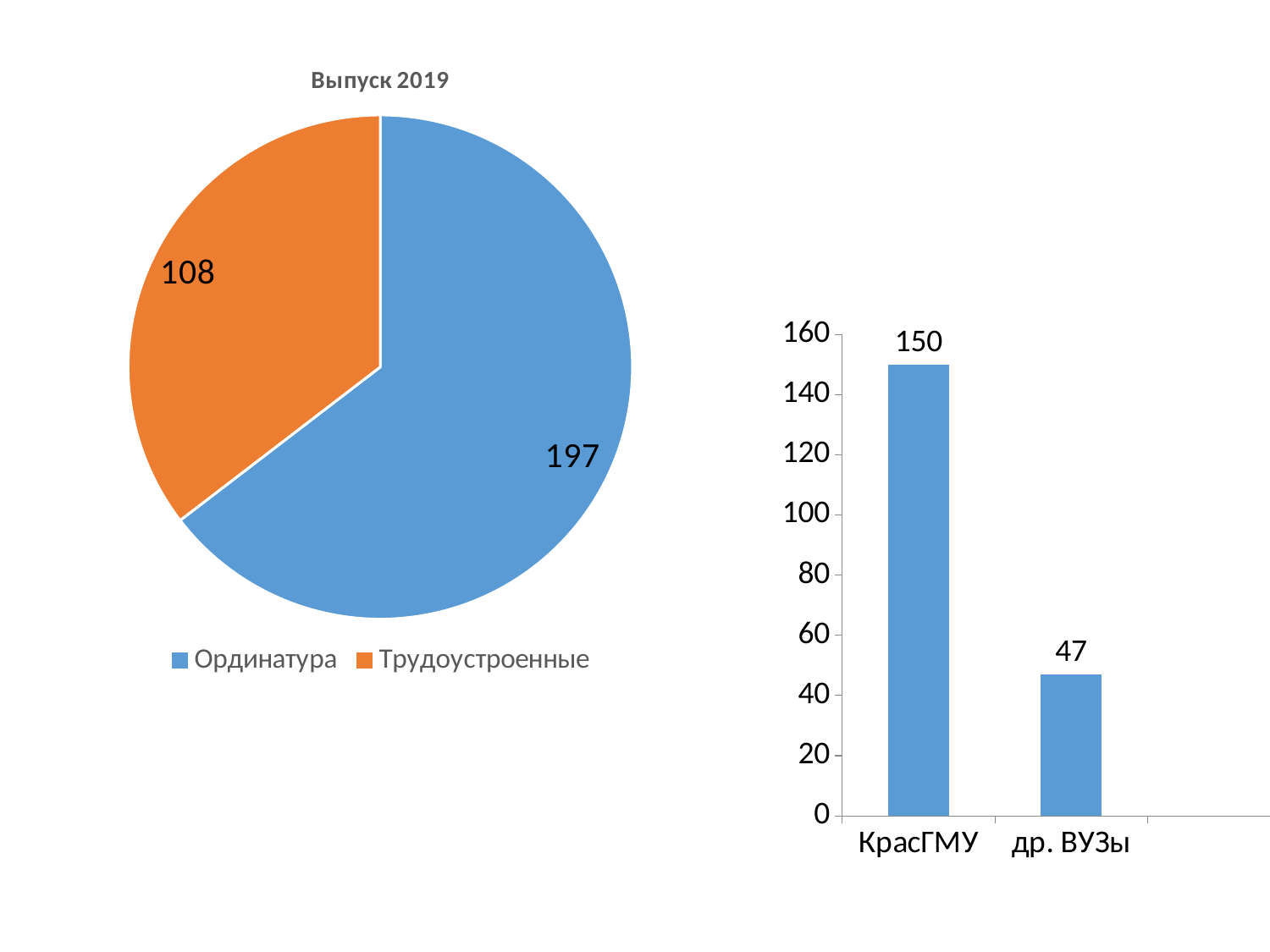
In the pie chart titled 'Выпуск 2019', which category has the larger value? Ординатура In the pie chart titled 'Выпуск 2019', what is the difference between Ординатура and Трудоустроенные? 89 In the bar chart on the right, what is the value for др. ВУЗы? 47 In the bar chart on the right, which category has the lowest value? др. ВУЗы In the pie chart titled 'Выпуск 2019', what colour is the Трудоустроенные slice? Orange In the bar chart on the right, what is the difference between КрасГМУ and др. ВУЗы? 103 In the pie chart titled 'Выпуск 2019', what is the value for Ординатура? 197 In the pie chart titled 'Выпуск 2019', what is the value for Трудоустроенные? 108 In the bar chart on the right, what is the value for КрасГМУ? 150 In the pie chart titled 'Выпуск 2019', what is the total of the two slices? 305 In the pie chart titled 'Выпуск 2019', how many entries does the legend list? 2 What kind of chart is shown on the right side of the slide? Bar chart